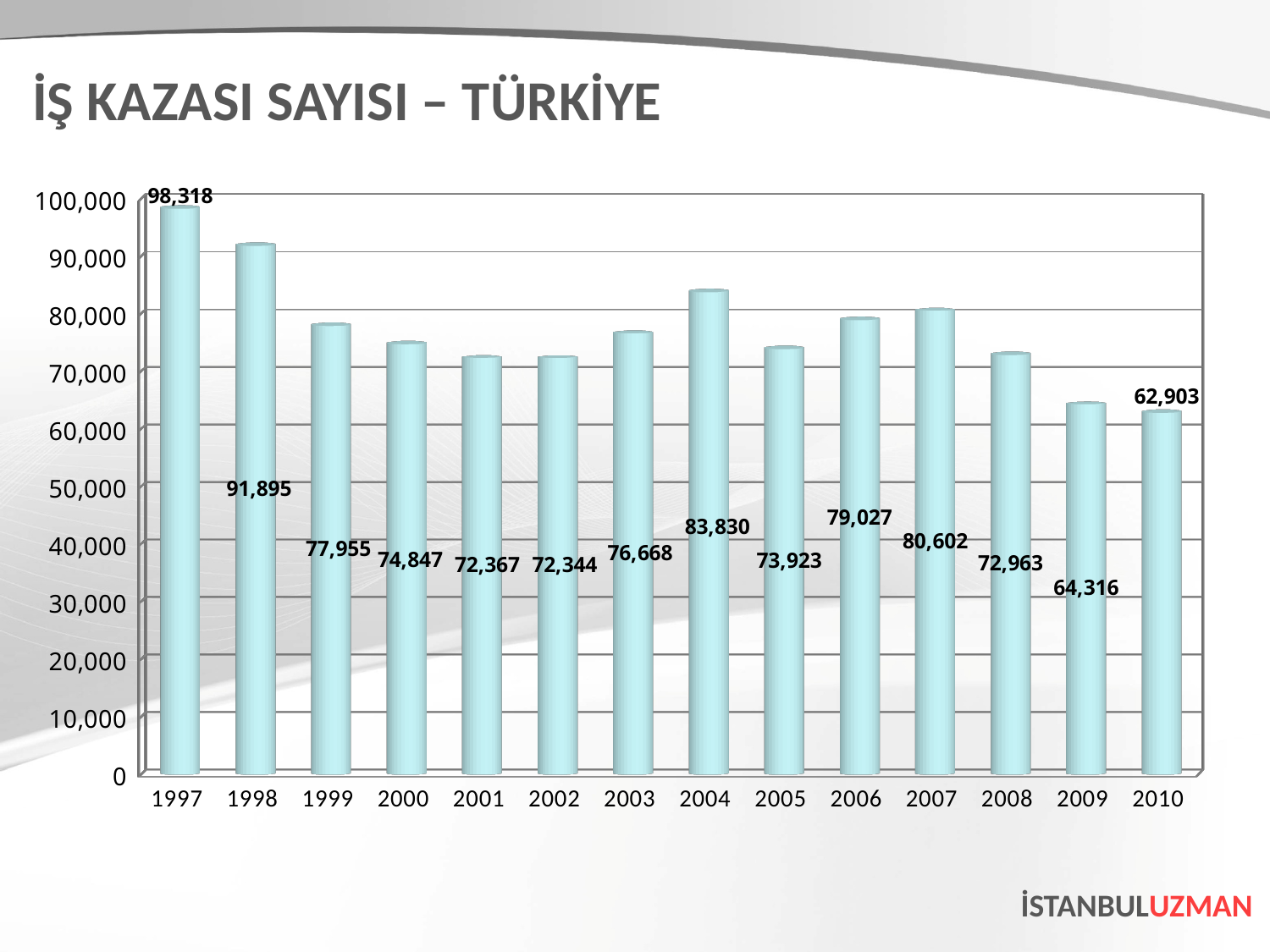
What is the value for 2010? 62,903 What is the value for 2004? 83,830 What kind of chart is shown on the slide? bar chart What is the title of the slide? İŞ KAZASI SAYISI – TÜRKİYE Which year has the highest value? 1997 What is the difference between the values for 2009 and 2010? 1,413 Which year has the lowest value? 2010 How many years are shown on the x axis? 14 Which is larger, the value for 2004 or the value for 2007? 2004 What is the difference between the values for 1997 and 1998? 6,423 What is the value for 1997? 98,318 Is the value for 2006 greater or less than 70,000? greater